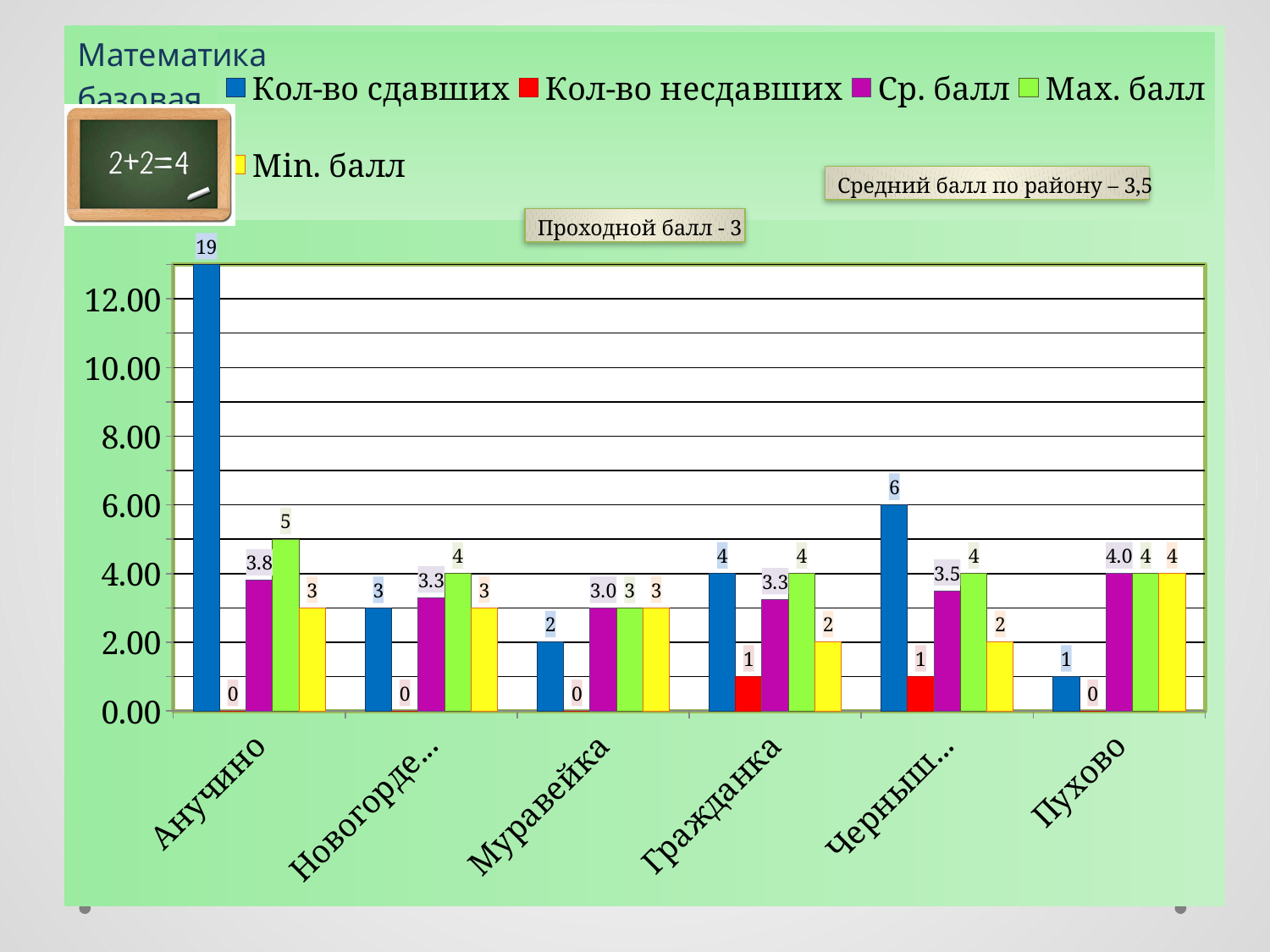
Which category has the highest Кол-во сдавших value? Анучино What is the value of Кол-во сдавших for Анучино? 19 What is the Кол-во несдавших value for Гражданка? 1 What is the Max. балл value for Анучино? 5 What is the Ср. балл value for Пухово? 4.0 Which has the larger Max. балл value, Анучино or Муравейка? Анучино Which category has the lowest Кол-во сдавших value? Пухово What is the difference between the Кол-во сдавших values for Анучино and Гражданка? 15 Is the Кол-во сдавших value for Анучино greater or less than 12.00? greater What is the Min. балл value for Гражданка? 2 How many categories are shown on the x axis of the chart? 6 How many series does the legend list? 5